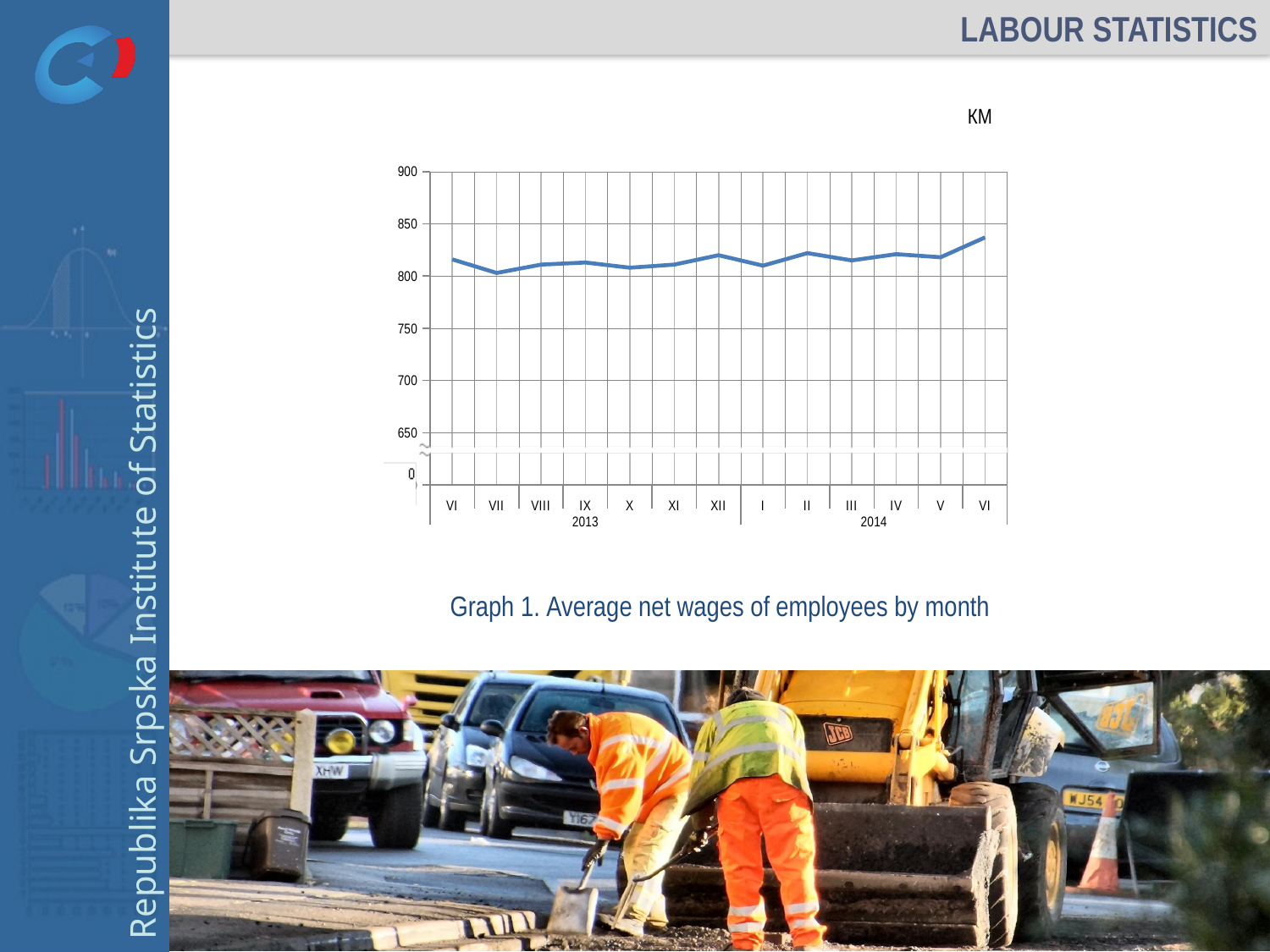
Which month has the highest average net wage on the chart? VI 2014 What is the title of the chart on the slide? Graph 1. Average net wages of employees by month Is the value for XII 2013 greater or less than 750? greater Which is larger, the value for VII 2013 or the value for XII 2013? XII 2013 Which is larger, the value for VI 2014 or the value for VII 2013? VI 2014 What kind of chart is shown on the slide? line chart Is the value for VI 2014 greater or less than 800? greater What unit is indicated for the values in the chart? KM Is the value for VII 2013 greater or less than 850? less How many monthly data points are plotted on the chart? 13 Overall, does the line rise or fall from VI 2013 to VI 2014? rise